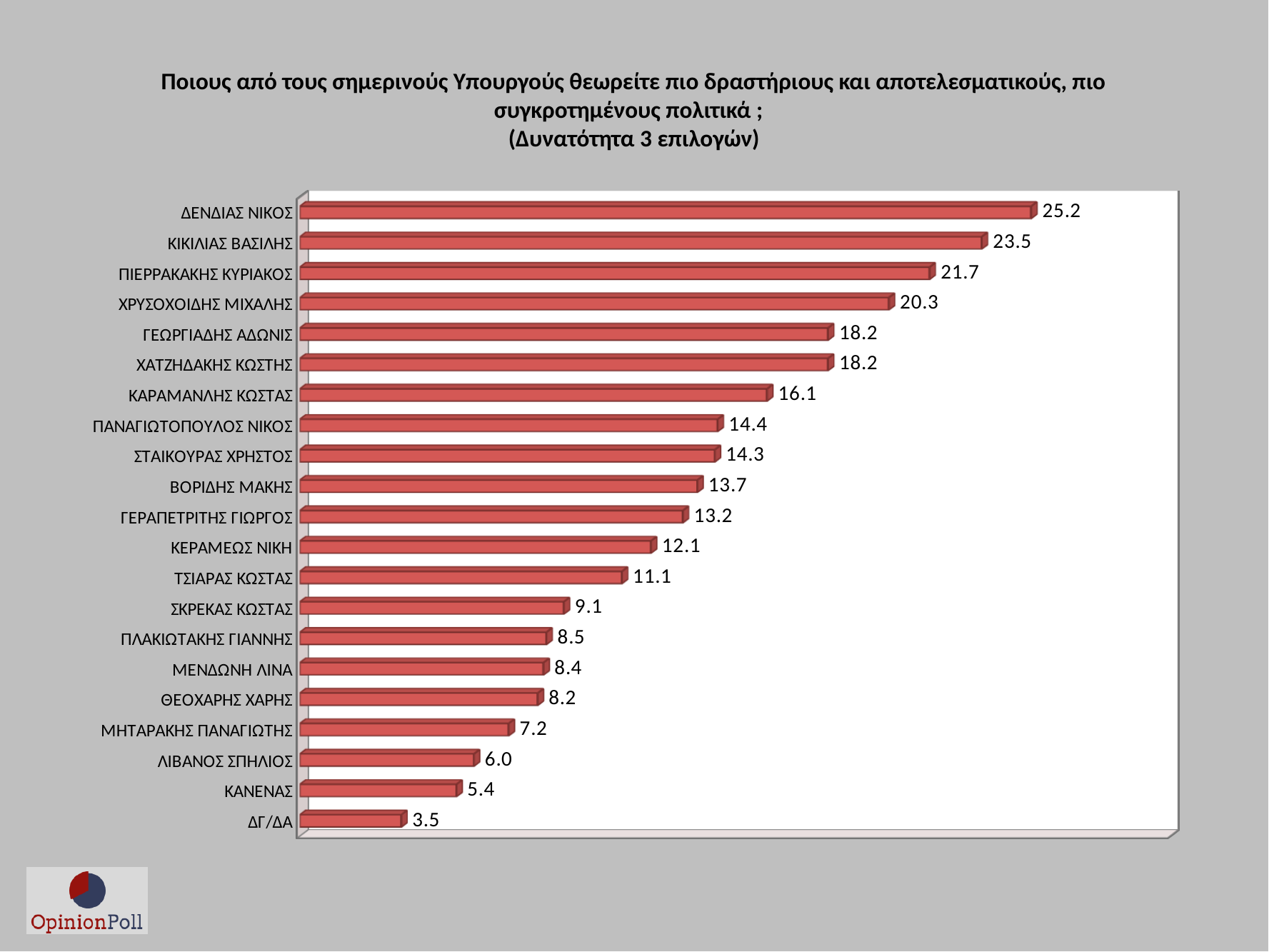
Which category has the highest value? ΔΕΝΔΙΑΣ ΝΙΚΟΣ What is the value for ΚΑΡΑΜΑΝΛΗΣ ΚΩΣΤΑΣ? 16.1 What is the difference between the values for ΧΡΥΣΟΧΟΙΔΗΣ ΜΙΧΑΛΗΣ and ΛΙΒΑΝΟΣ ΣΠΗΛΙΟΣ? 14.3 Which category has the lowest value? ΔΓ/ΔΑ What kind of chart is shown on the slide? Bar chart What is the value for ΚΕΡΑΜΕΩΣ ΝΙΚΗ? 12.1 How many categories are shown in the chart? 21 Which has a larger value, ΠΙΕΡΡΑΚΑΚΗΣ ΚΥΡΙΑΚΟΣ or ΣΤΑΙΚΟΥΡΑΣ ΧΡΗΣΤΟΣ? ΠΙΕΡΡΑΚΑΚΗΣ ΚΥΡΙΑΚΟΣ What is the difference between the values for ΔΕΝΔΙΑΣ ΝΙΚΟΣ and ΚΙΚΙΛΙΑΣ ΒΑΣΙΛΗΣ? 1.7 Which two categories share the value 18.2? ΓΕΩΡΓΙΑΔΗΣ ΑΔΩΝΙΣ and ΧΑΤΖΗΔΑΚΗΣ ΚΩΣΤΗΣ What is the value for ΔΕΝΔΙΑΣ ΝΙΚΟΣ? 25.2 What is the value for ΚΑΝΕΝΑΣ? 5.4